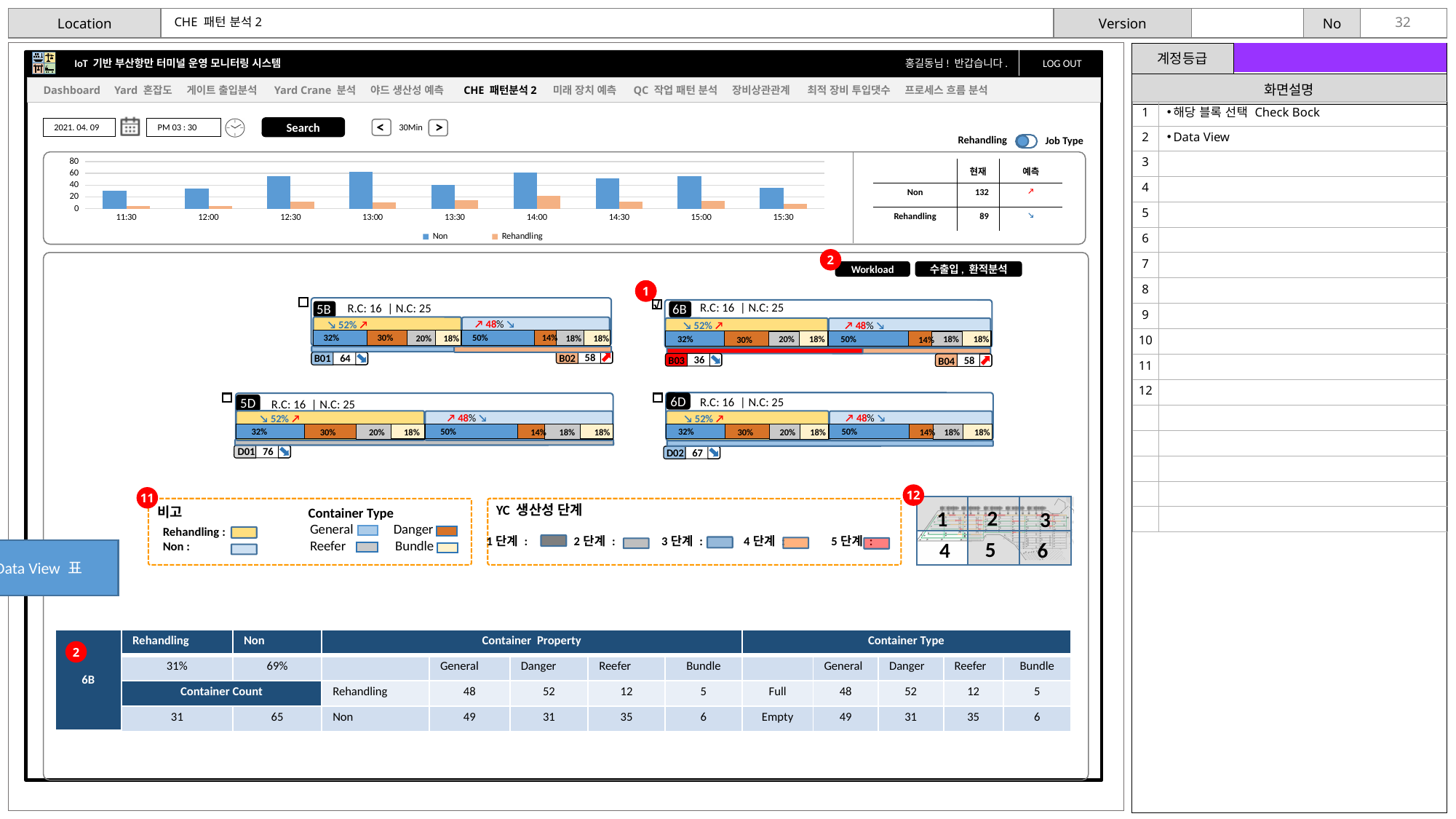
What are the two series named in the legend of the top bar chart? Non and Rehandling In the top bar chart, which is larger: the Non bar at 13:00 or the Non bar at 11:30? 13:00 In the top bar chart, is the Non value at 13:00 greater or less than 40? greater What is the highest value shown on the y axis of the top bar chart? 80 In the top bar chart, is the Rehandling value at 14:00 greater or less than 40? less How many time categories are shown on the x axis of the top bar chart? 9 In the top bar chart, is the Non value at 12:30 greater or less than 40? greater What kind of chart is shown at the top of the dashboard (the chart with time labels 11:30 to 15:30)? bar chart How many series does the legend of the top time-series bar chart list? 2 In the top bar chart, at which time is the Rehandling bar highest? 14:00 In the top bar chart, which is larger at 14:00: the Non bar or the Rehandling bar? Non